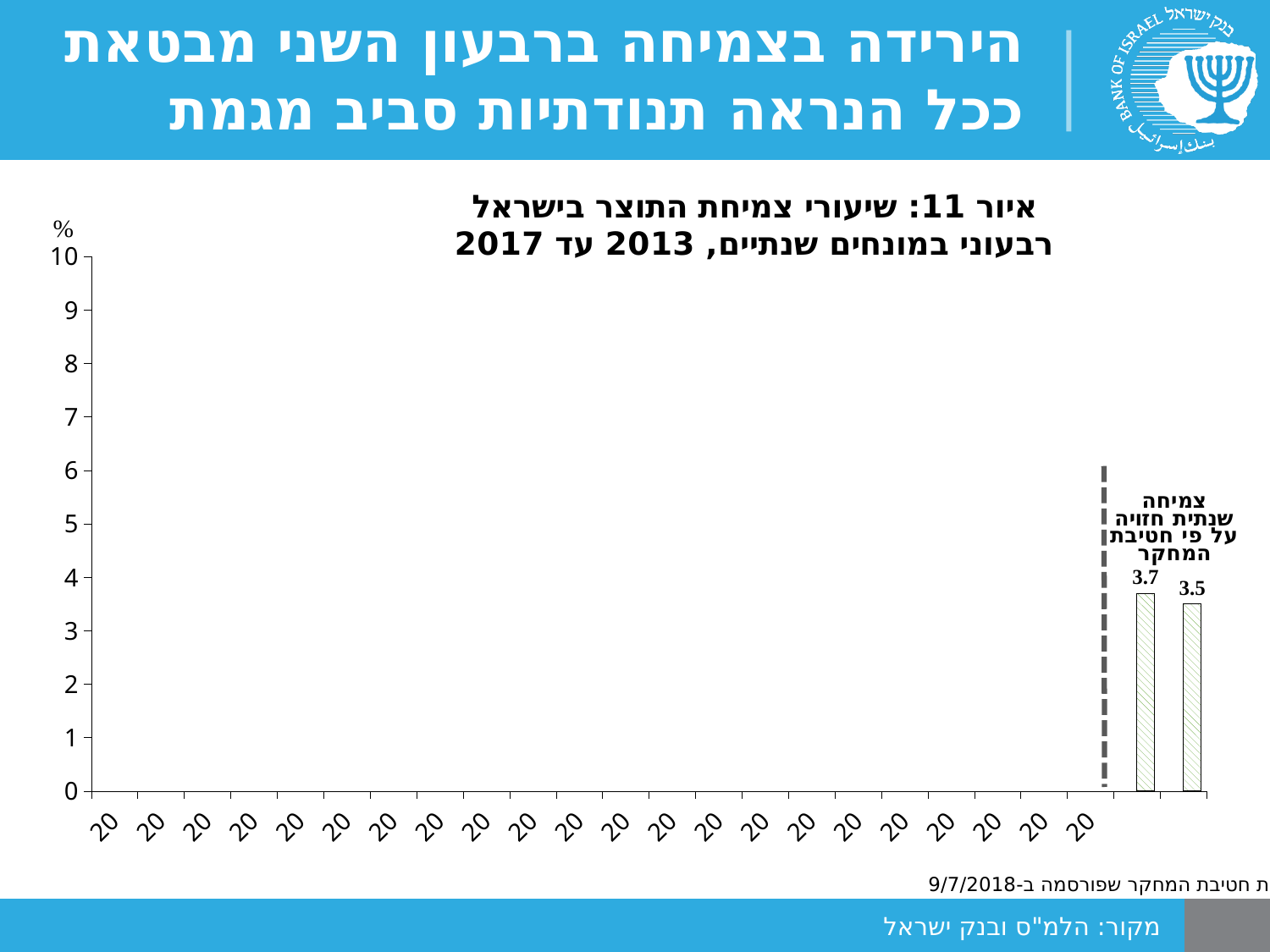
What kind of chart is shown on the slide? bar chart What is the difference between the two labelled forecast bars (3.7 and 3.5)? 0.2 Is the value of the forecast bar labelled 3.5 greater or less than 4? less What is the highest value printed on the chart's y-axis? 10 What is the value shown on the rightmost hatched forecast bar? 3.5 How many labelled forecast bars appear to the right of the dashed vertical line? 2 Is the value of the forecast bar labelled 3.7 greater or less than 3? greater Which of the two labelled forecast bars is larger, the one labelled 3.7 or the one labelled 3.5? 3.7 What is the value shown on the left hatched forecast bar at the right side of the chart? 3.7 What unit is shown at the top of the chart's y-axis? %